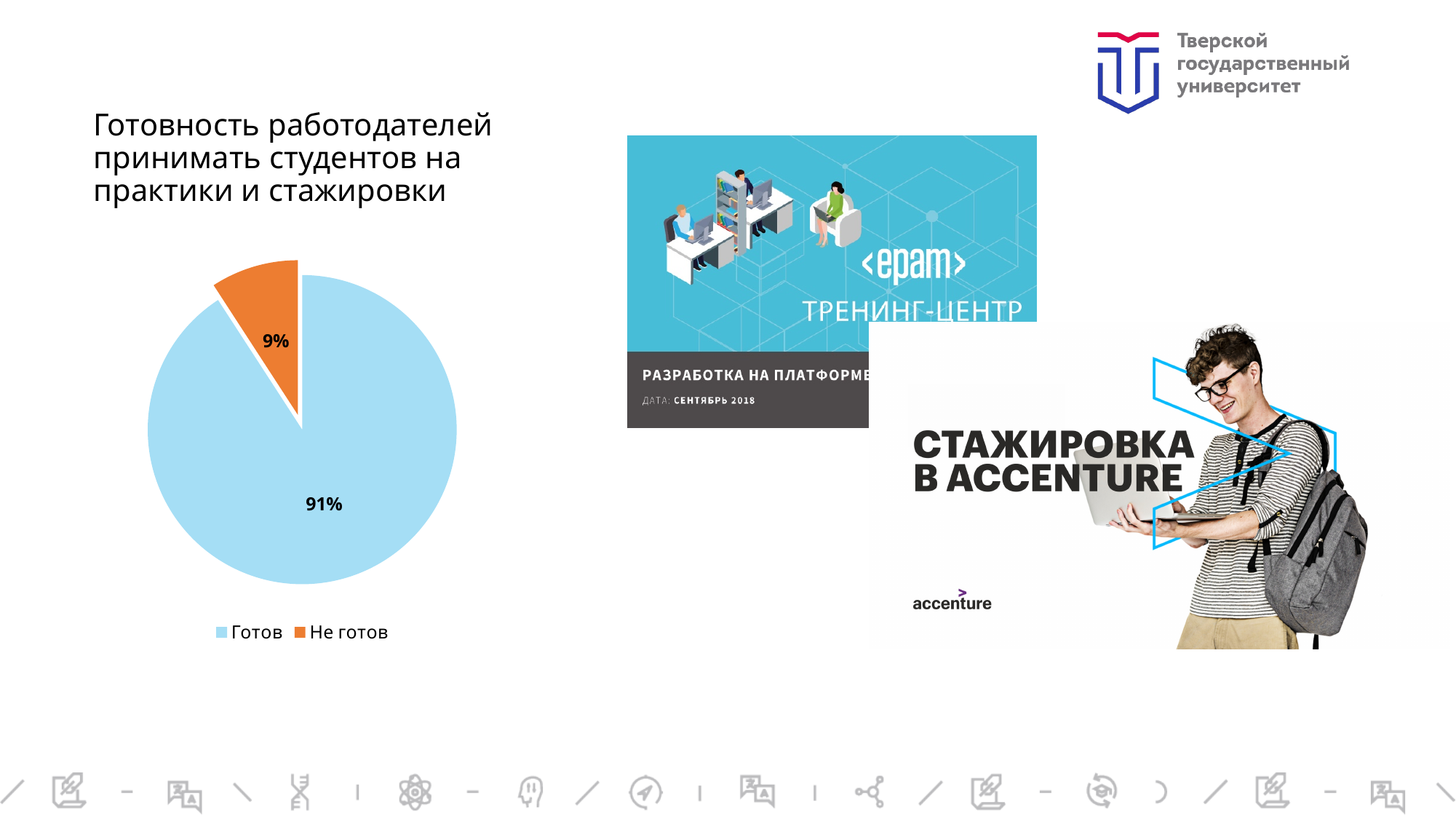
Which category has the largest slice of the pie? Готов Which slice is larger, "Готов" or "Не готов"? Готов What is the difference in percentage points between the "Готов" and "Не готов" slices? 82 What kind of chart is shown on the slide? pie chart What share of the pie is labelled "Готов"? 91% What is the title of the pie chart? Готовность работодателей принимать студентов на практики и стажировки How many entries does the legend list? 2 What share of the pie is labelled "Не готов"? 9% How many slices does the pie chart have? 2 What colour is the "Не готов" slice? orange Which category has the smallest slice of the pie? Не готов